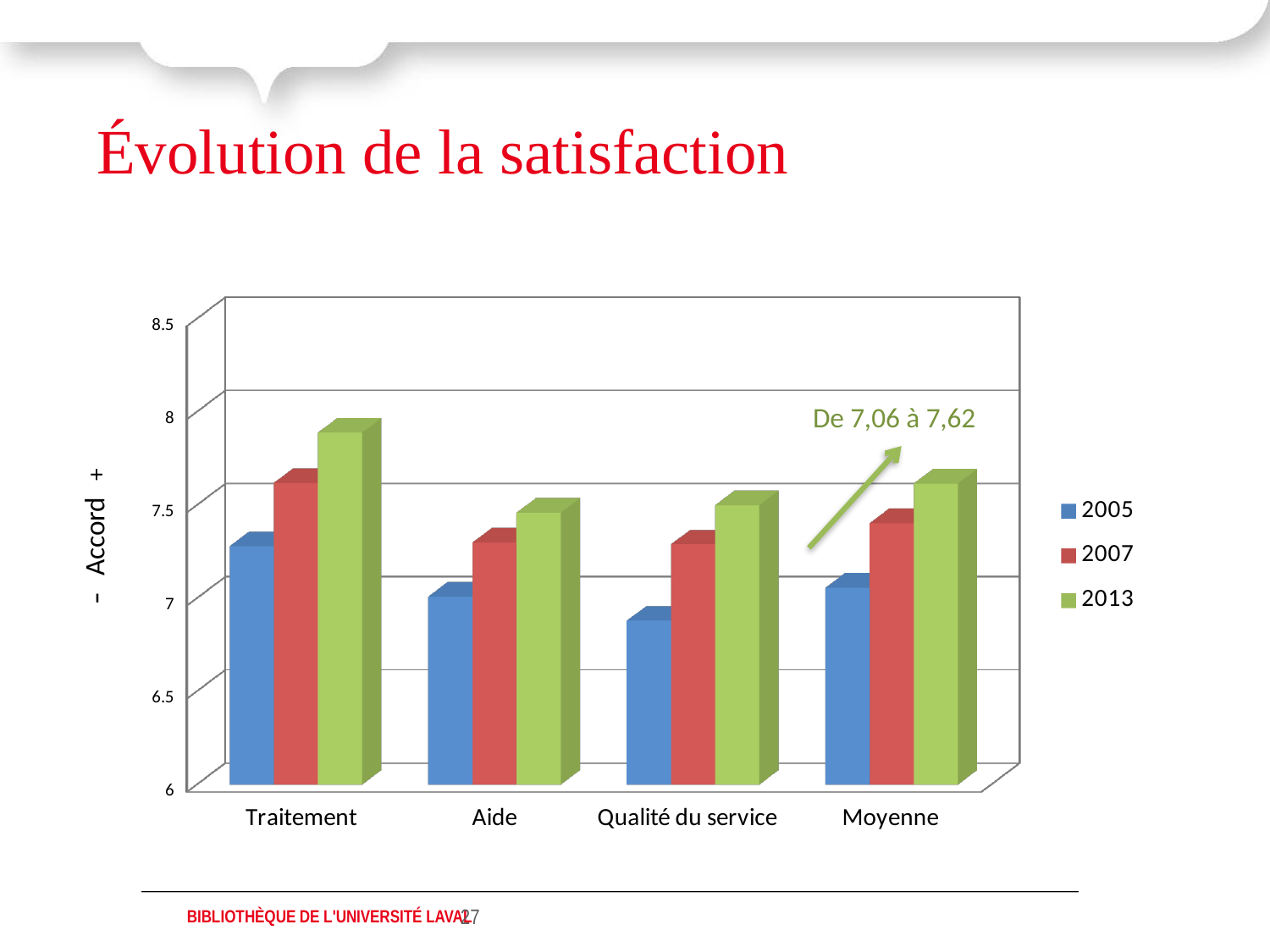
Which is larger, the 2013 value for Traitement or the 2013 value for Aide? Traitement What kind of chart is shown on the slide? bar chart What range does the annotation next to the Moyenne bars give? De 7,06 à 7,62 Is the 2005 value for Traitement greater or less than 7? greater Is the 2013 value for Traitement greater or less than 7.5? greater Which category has the lowest value for the 2005 series? Qualité du service How many series does the chart's legend list? 3 Is the 2005 value for Qualité du service greater or less than 7? less Which category has the highest value for the 2013 series? Traitement Within each category, do the values rise or fall from 2005 to 2013? rise How many categories are shown on the x axis of the chart? 4